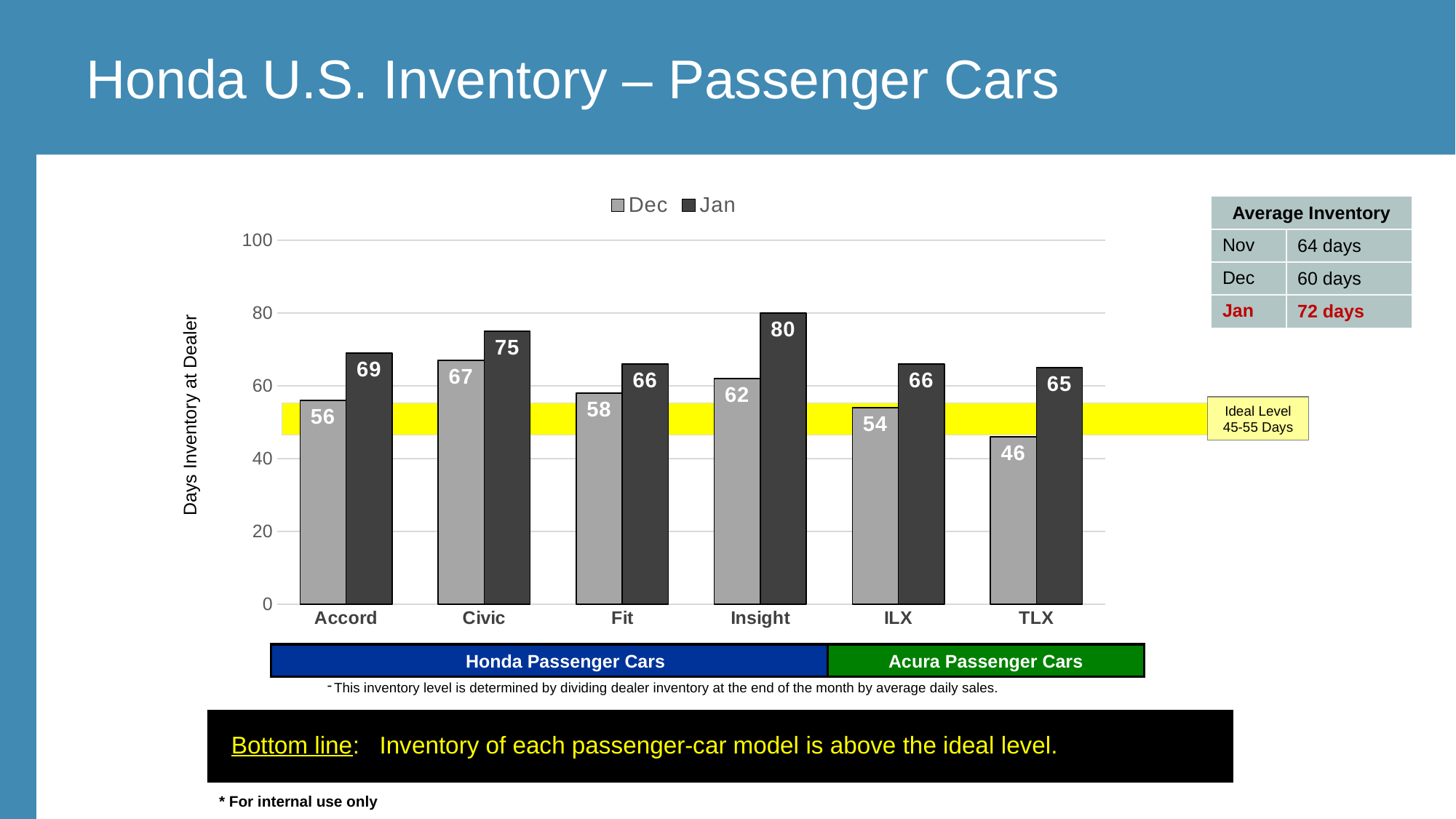
How many car models are shown on the x axis? 6 What kind of chart is shown on the slide? bar chart What is the difference between the Jan values for Insight and Accord? 11 Is the Jan value for Civic greater or less than 80? less Which is larger, the Dec value for Civic or the Dec value for Insight? Civic Which model has the highest Jan days inventory? Insight What is the Jan days inventory value for Insight? 80 What is the Dec value for Civic? 67 How many series does the legend list? 2 Which model has the lowest Dec days inventory? TLX What is the difference between the Jan and Dec values for TLX? 19 What is the Dec days inventory value for TLX? 46